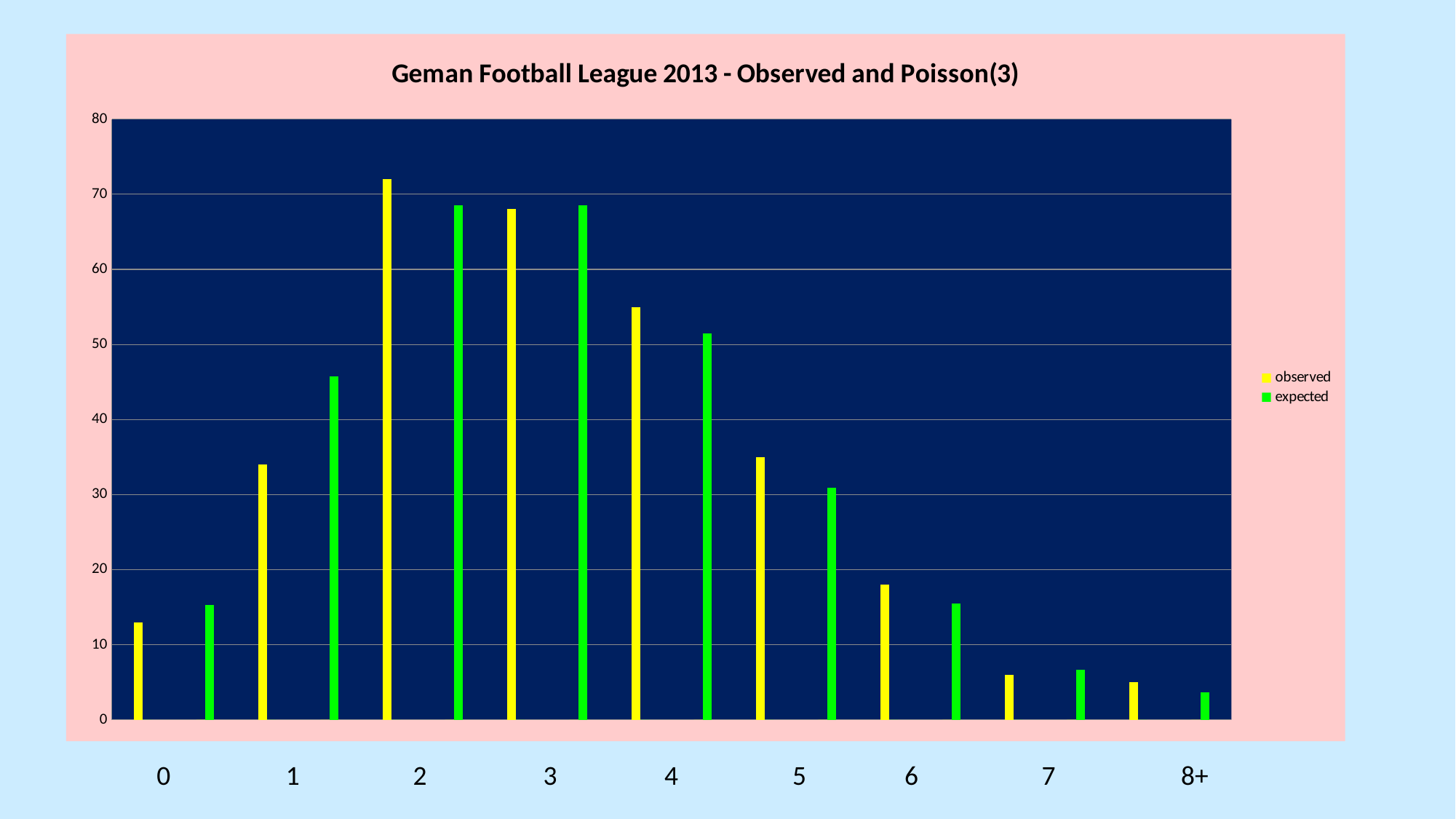
What kind of chart is shown on the slide? bar chart Which category has the highest observed value? 2 Is the expected value for category 1 greater or less than 40? greater How many categories are shown on the x axis? 9 Is the observed value for category 6 greater or less than 20? less For category 1, which is larger, the observed or the expected value? expected Is the observed value for category 4 greater or less than 50? greater How many series does the legend list? 2 What is the title of the chart? Geman Football League 2013 - Observed and Poisson(3) For category 4, which is larger, the observed or the expected value? observed Which category has the lowest expected value? 8+